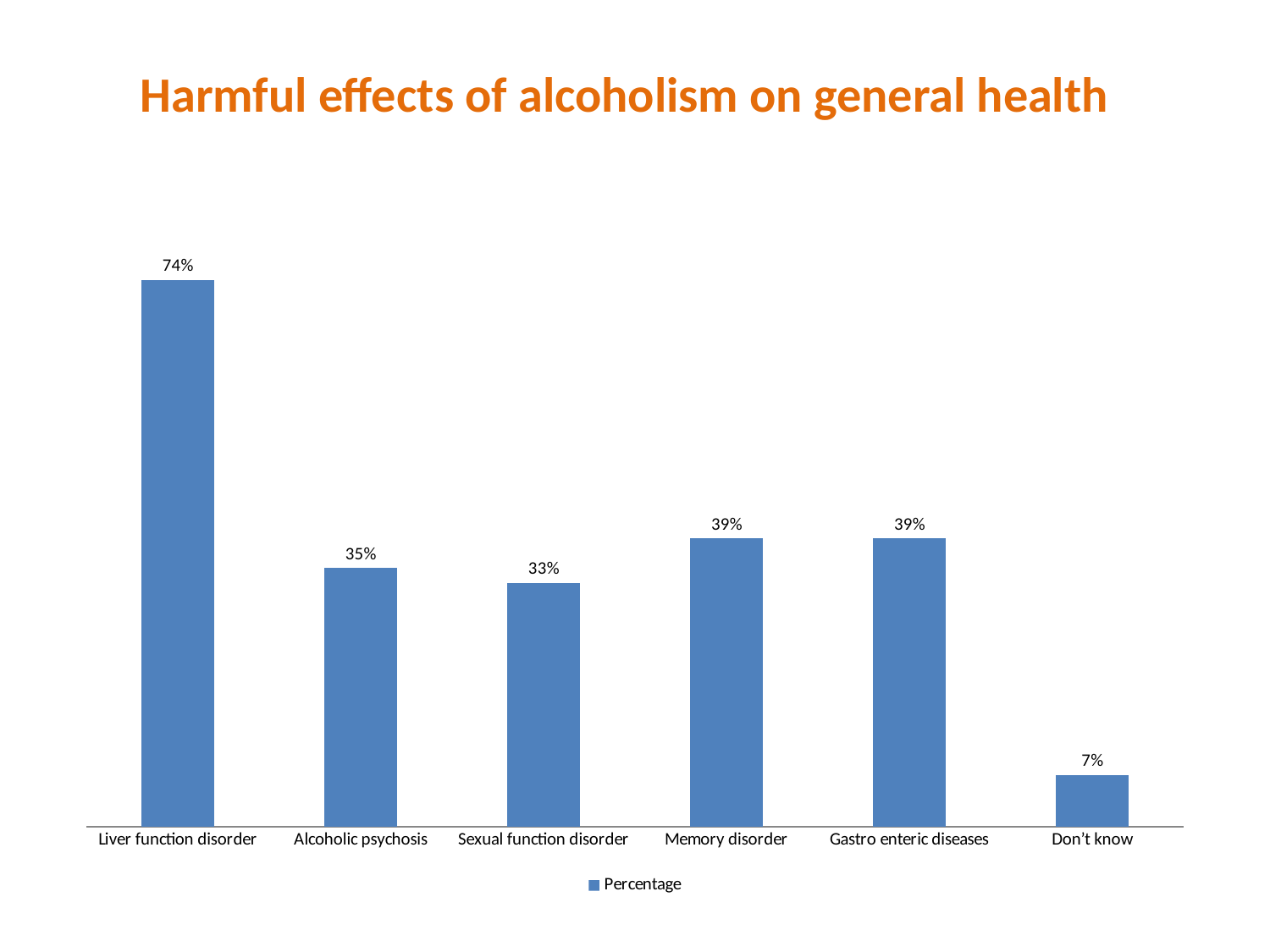
Which is larger, the percentage for Gastro enteric diseases or for Alcoholic psychosis? Gastro enteric diseases What is the difference between the percentages for Alcoholic psychosis and Sexual function disorder? 2% What is the percentage for Liver function disorder? 74% What is the difference between the percentages for Liver function disorder and Memory disorder? 35% Which category has the highest percentage? Liver function disorder What is the title of the chart? Harmful effects of alcoholism on general health What is the percentage for Sexual function disorder? 33% How many categories are shown on the x axis? 6 What is the percentage for Alcoholic psychosis? 35% What is the percentage for Don't know? 7% Which category has the lowest percentage? Don't know What kind of chart is shown on the slide? Bar chart